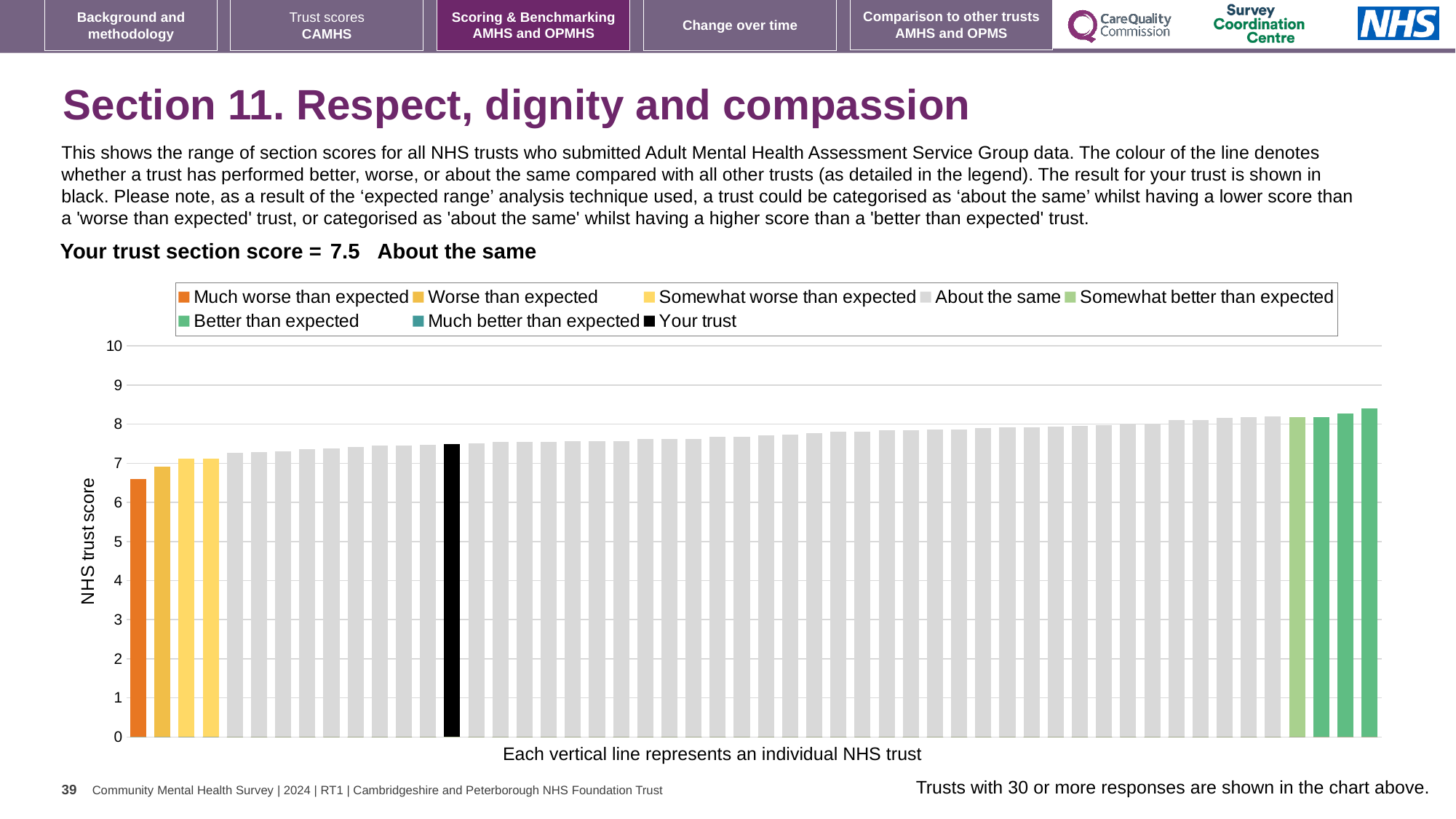
How many entries does the chart legend list? 8 Which category is your trust placed in for this section? About the same Which legend category does the highest bar in the chart belong to? Better than expected Do the bar values rise or fall from left to right across the chart? rise Which legend category does the lowest bar in the chart belong to? Much worse than expected What kind of chart is shown on the slide? Bar chart Is the value of the black 'Your trust' bar greater or less than 7? greater What is the section score for your trust shown on the slide? 7.5 Is the value of the orange 'Much worse than expected' bar greater or less than 7? less What is the title of the vertical axis? NHS trust score What colour is the bar representing your trust? Black Is the value of the rightmost green bar greater or less than 8? greater